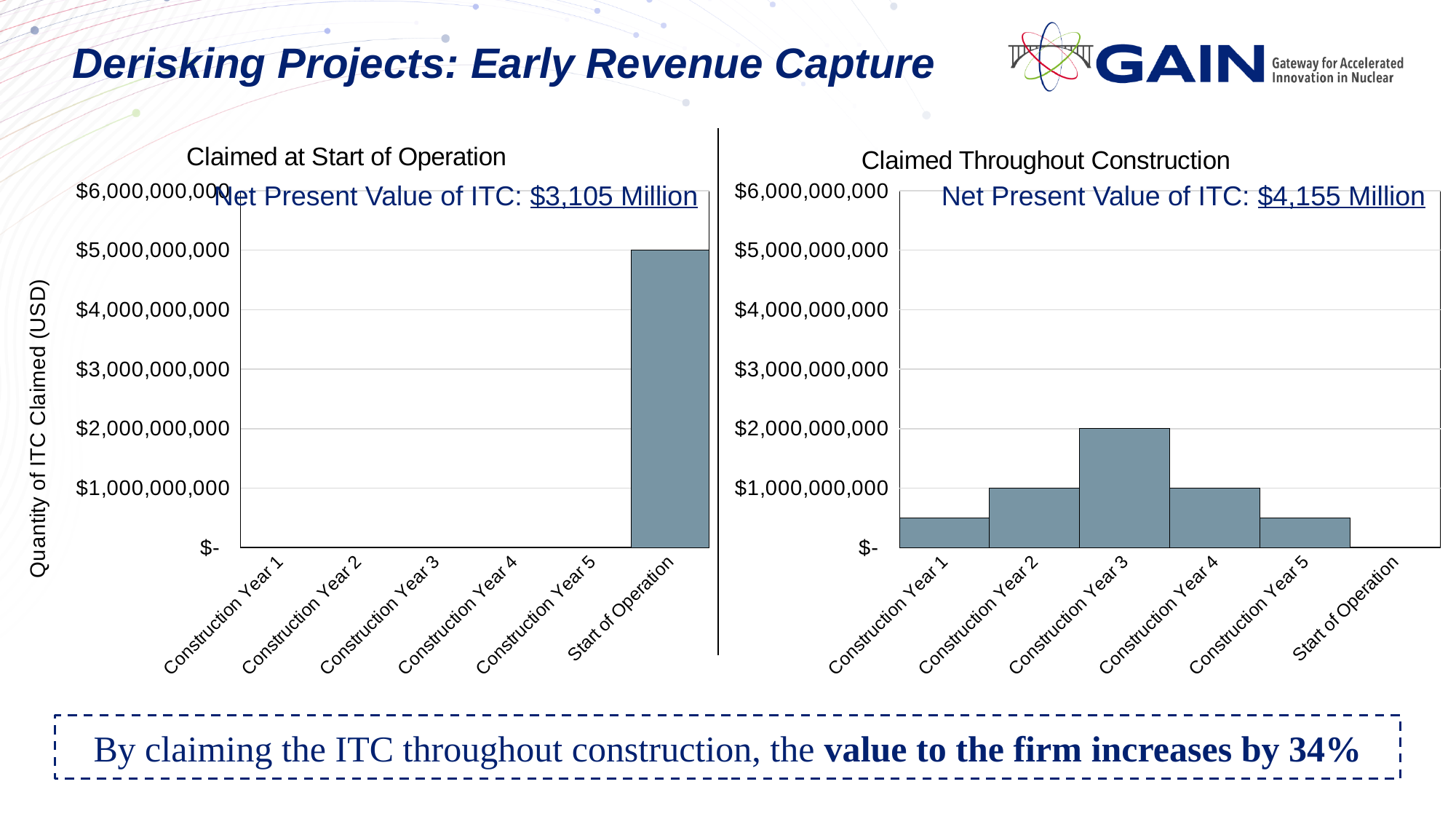
What kind of chart is the 'Claimed at Start of Operation' chart? Bar chart How many categories are shown on the x axis of the 'Claimed Throughout Construction' chart? 6 In the 'Claimed Throughout Construction' chart, which is larger, Construction Year 3 or Construction Year 5? Construction Year 3 In the 'Claimed Throughout Construction' chart, what is the value for Construction Year 3? $2,000,000,000 In the 'Claimed Throughout Construction' chart, do the values rise or fall from Construction Year 3 to Start of Operation? Fall In the 'Claimed Throughout Construction' chart, what is the value for Construction Year 2? $1,000,000,000 In the 'Claimed Throughout Construction' chart, what is the difference between Construction Year 3 and Construction Year 4? $1,000,000,000 What Net Present Value of ITC is stated on the 'Claimed Throughout Construction' chart? $4,155 Million In the 'Claimed at Start of Operation' chart, which category has the highest value? Start of Operation In the 'Claimed Throughout Construction' chart, is the value for Construction Year 1 greater or less than $1,000,000,000? less In the 'Claimed at Start of Operation' chart, what is the value for Start of Operation? $5,000,000,000 In the 'Claimed Throughout Construction' chart, which category has the highest value? Construction Year 3